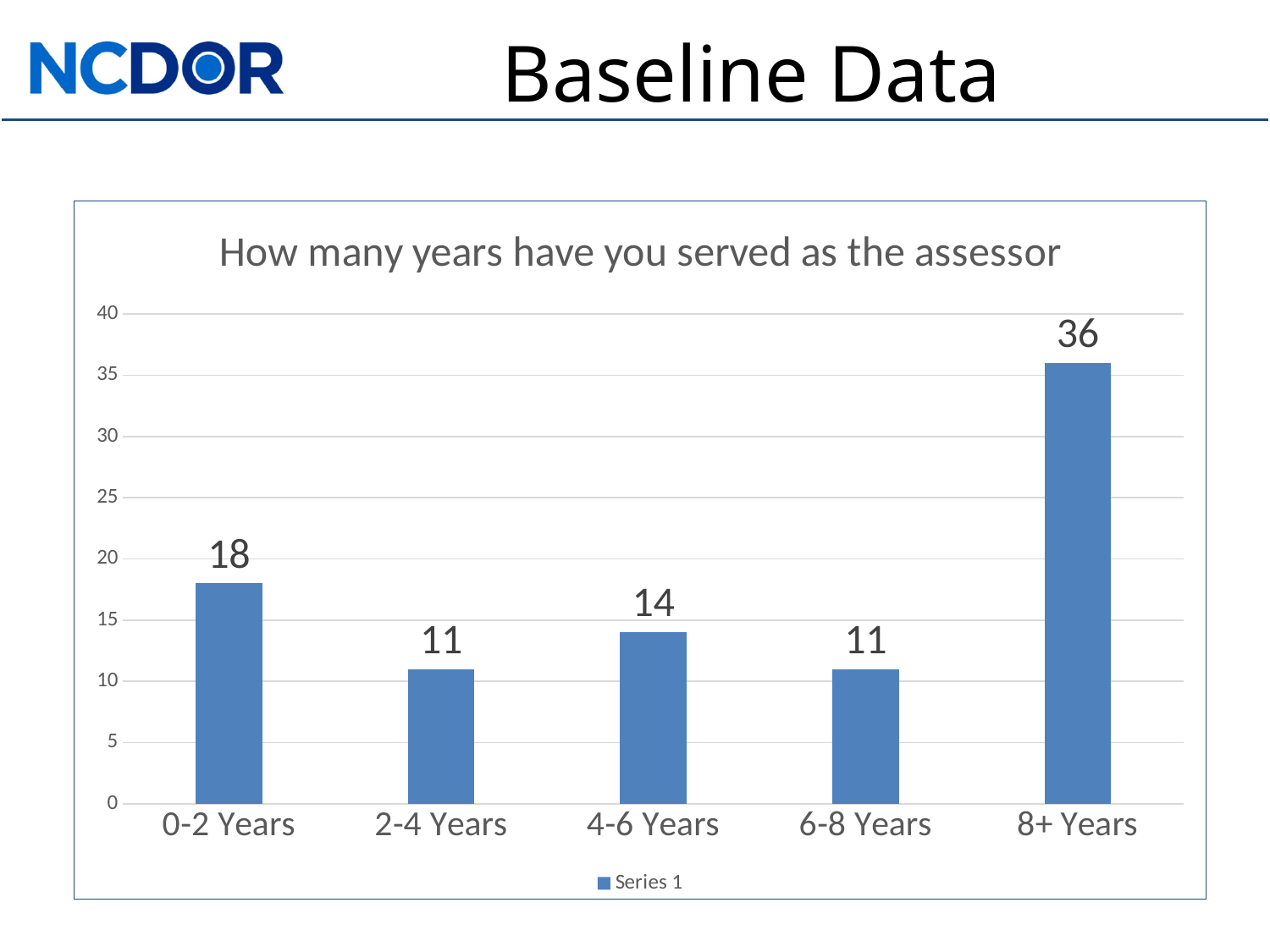
What is the value for 0-2 Years? 18 Is the value for 8+ Years greater or less than 30? greater Which is larger, the value for 0-2 Years or the value for 4-6 Years? 0-2 Years How many series does the legend list? 1 Which category has the highest value? 8+ Years What is the value for 4-6 Years? 14 How many categories are shown on the x axis? 5 What is the title of the chart? How many years have you served as the assessor What is the legend entry shown below the chart? Series 1 What kind of chart is shown? bar chart What is the value for 8+ Years? 36 What is the difference between the values for 8+ Years and 0-2 Years? 18